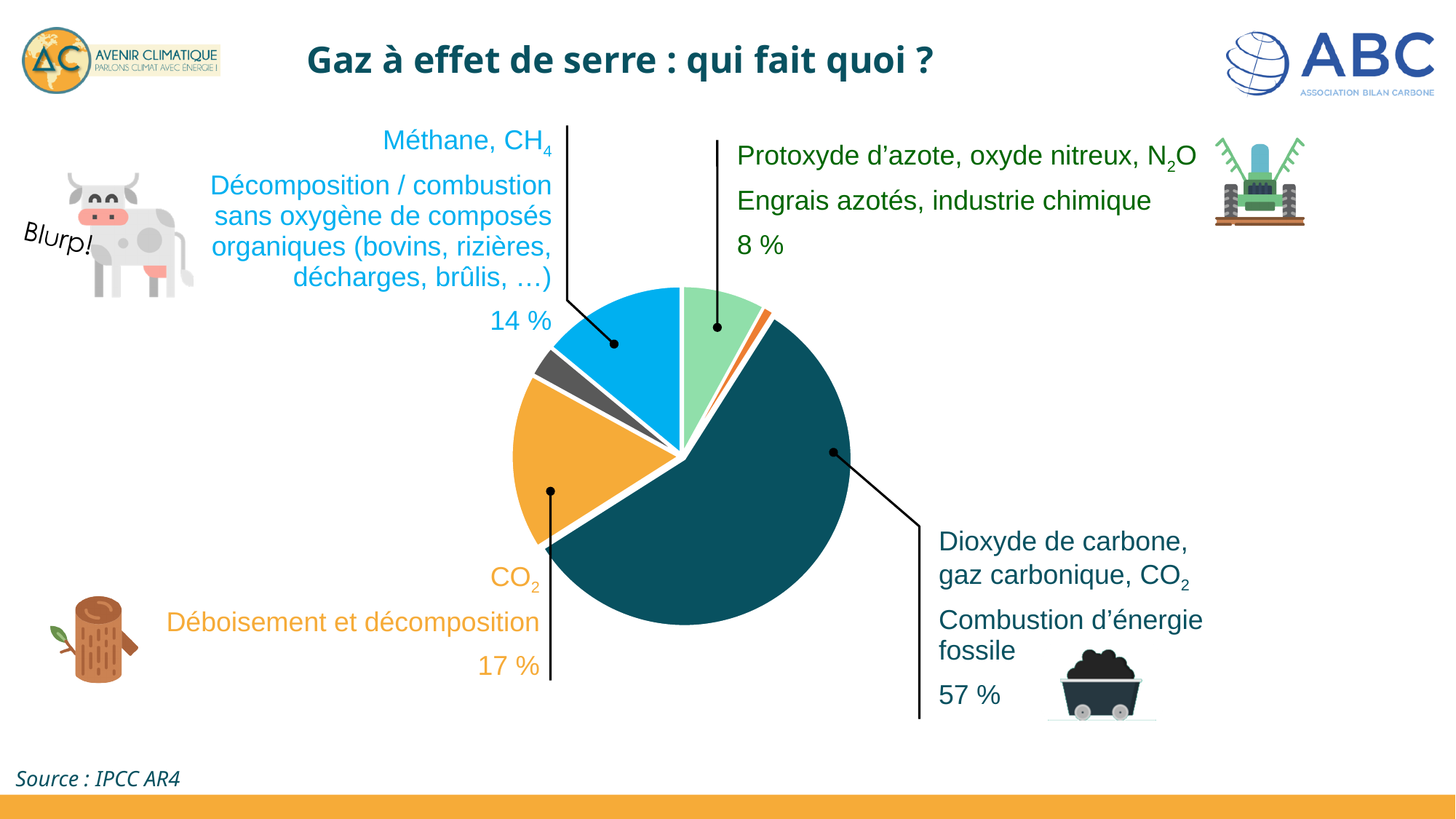
What is the combined share of the two CO2 slices (fossil energy and deforestation)? 74 % What kind of chart is shown on the slide? pie chart What share of the pie is attributed to nitrous oxide (N2O)? 8 % What is the difference in percentage points between the fossil-energy CO2 slice and the deforestation CO2 slice? 40 What share of the pie is attributed to CO2 from deforestation and decomposition (Déboisement et décomposition)? 17 % What share of the pie is attributed to methane (CH4)? 14 % Which is larger: the methane (CH4) slice or the nitrous oxide (N2O) slice? Méthane, CH4 What share of the pie is attributed to CO2 from combustion of fossil energy (Combustion d'énergie fossile)? 57 % How many slices of the pie have a percentage label printed on the slide? 4 Which labelled slice of the pie is the largest? Dioxyde de carbone, combustion d'énergie fossile (57 %) What colour is the slice representing methane (CH4)? light blue Which labelled slice of the pie is the smallest? Protoxyde d'azote, N2O (8 %)